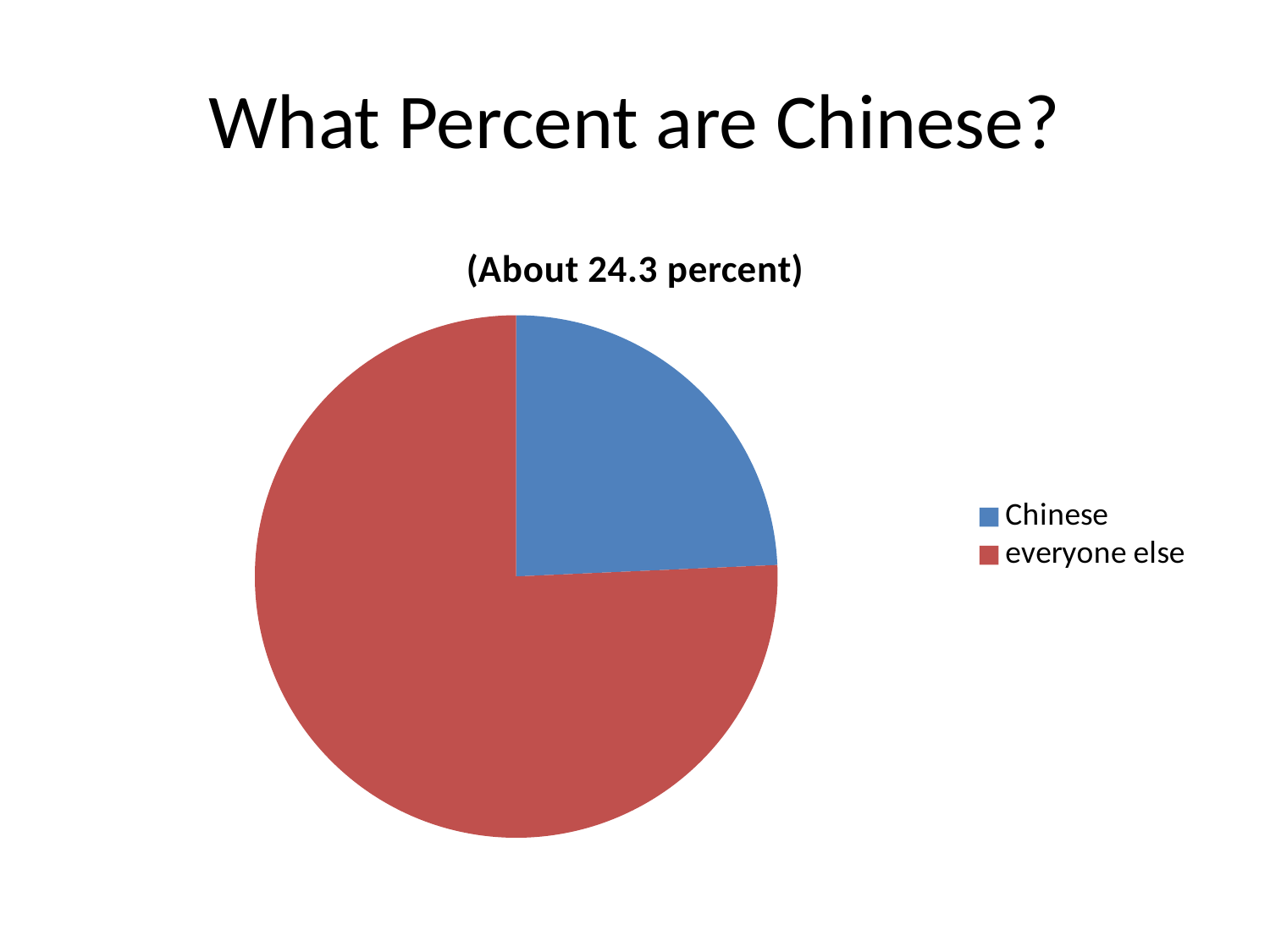
What kind of chart is shown on the slide? pie chart How many slices does the pie chart have? 2 Which slice is larger, Chinese or everyone else? everyone else What is the title printed above the pie chart? (About 24.3 percent) Which slice is the largest in the pie chart? everyone else What colour is the Chinese slice in the pie chart? blue Which slice is the smallest in the pie chart? Chinese How many entries does the legend list? 2 Is the Chinese slice more or less than half of the pie? less